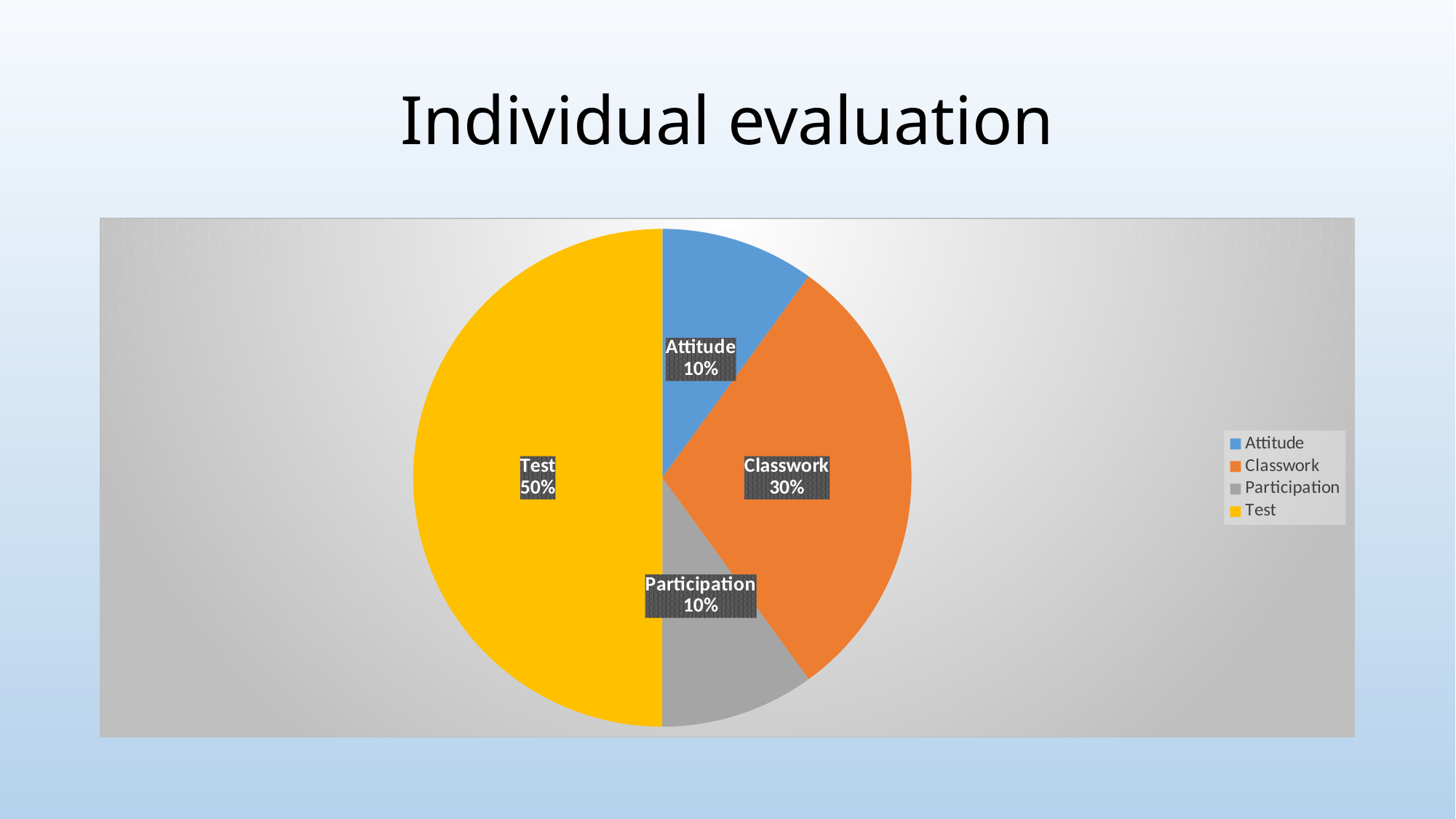
How many entries does the legend list? 4 What colour is the Test slice of the pie? yellow What is the difference between the Test and Classwork percentages? 20% What share of the pie does Test account for? 50% Which is larger, Classwork or Attitude? Classwork What is the value shown for Participation? 10% What is the title of the slide containing the pie chart? Individual evaluation What kind of chart is shown on the slide? pie chart What is the value shown for Attitude? 10% Which category has the largest slice of the pie? Test How many slices does the pie chart have? 4 What is the value shown for Classwork? 30%